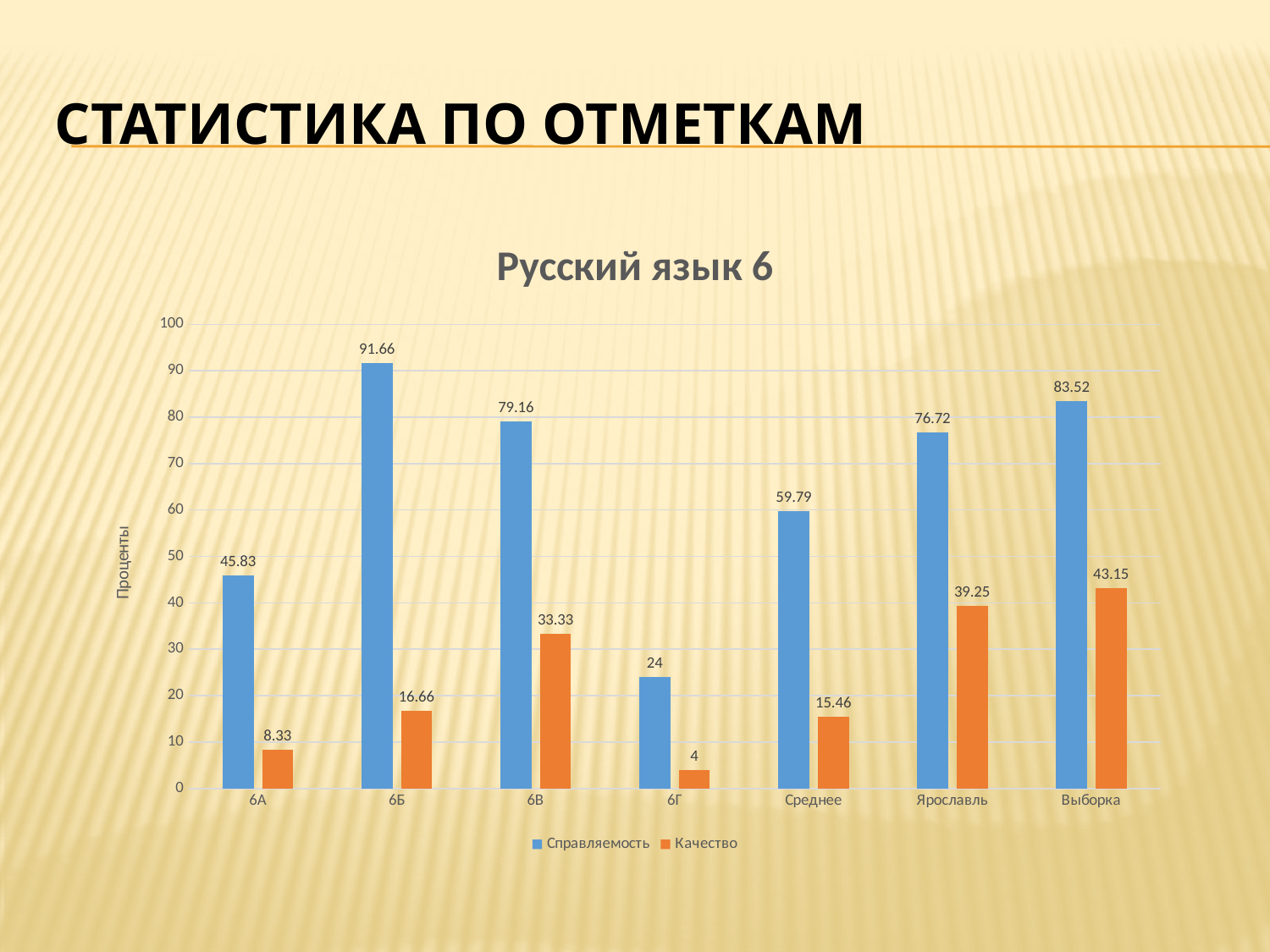
How many categories are shown on the x axis? 7 Which category has the highest Справляемость value? 6Б Which is larger: the Качество value for Выборка or for Ярославль? Выборка What is the Качество value for 6Г? 4 Which category has the lowest Качество value? 6Г How many series does the legend list? 2 Is the Справляемость value for Среднее greater or less than 50? greater What is the difference between the Справляемость and Качество values for 6В? 45.83 What kind of chart is shown on the slide? bar chart What is the Справляемость value for 6Б? 91.66 What is the Качество value for Ярославль? 39.25 What is the title of the chart? Русский язык 6